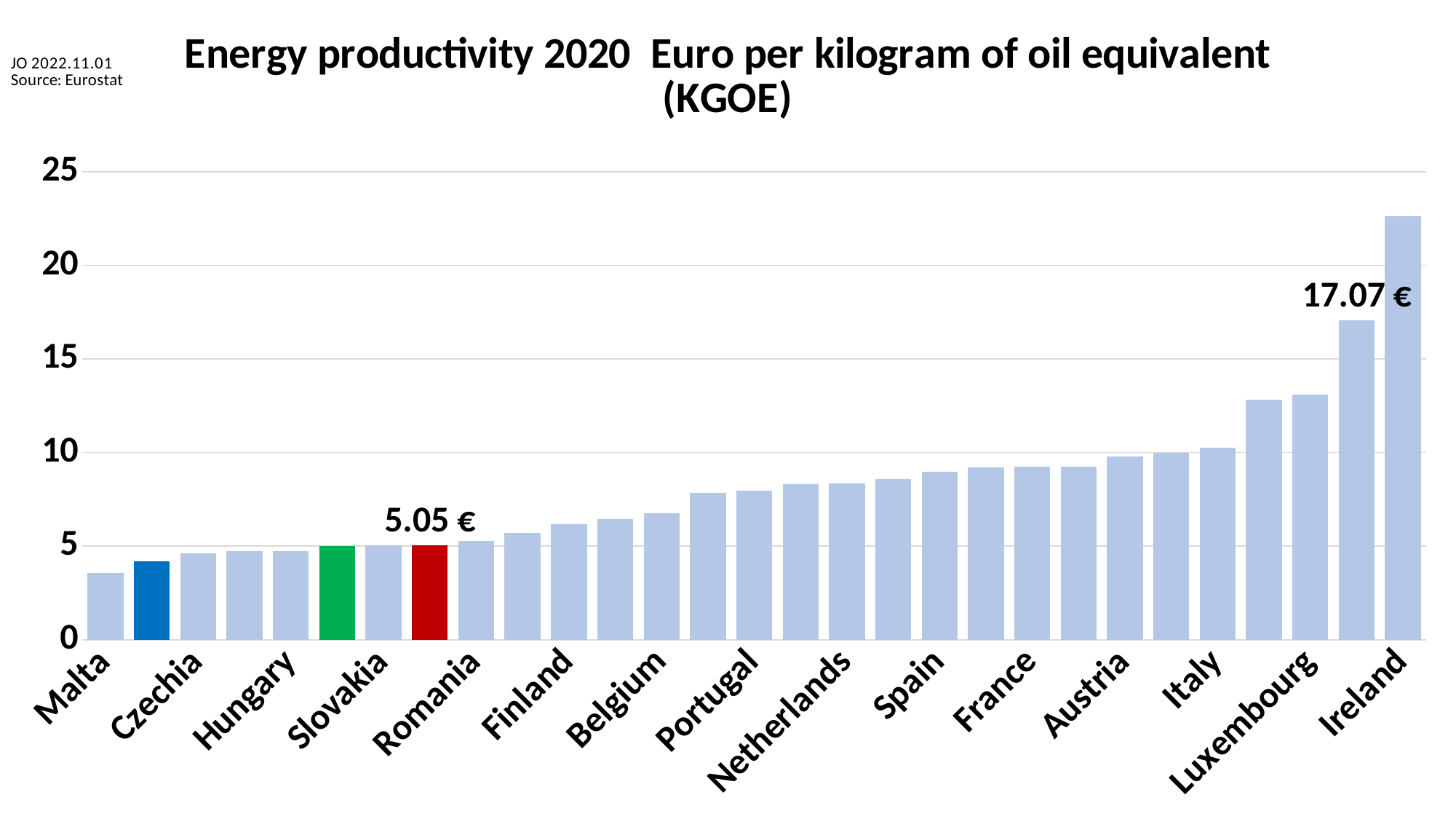
Which country has the lowest energy productivity in the chart? Malta Which has the larger value, Spain or Portugal? Spain Is the value for Ireland greater or less than 20? greater Is the value for Malta greater or less than 5? less Is the value for Netherlands greater or less than 10? less What value is printed as a data label above the red bar? 5.05 € Do the bar values rise or fall from left to right along the x axis? rise Which has the larger value, Ireland or Luxembourg? Ireland What source is cited for the chart data? Eurostat Which country has the highest energy productivity in the chart? Ireland What kind of chart is shown on the slide? bar chart